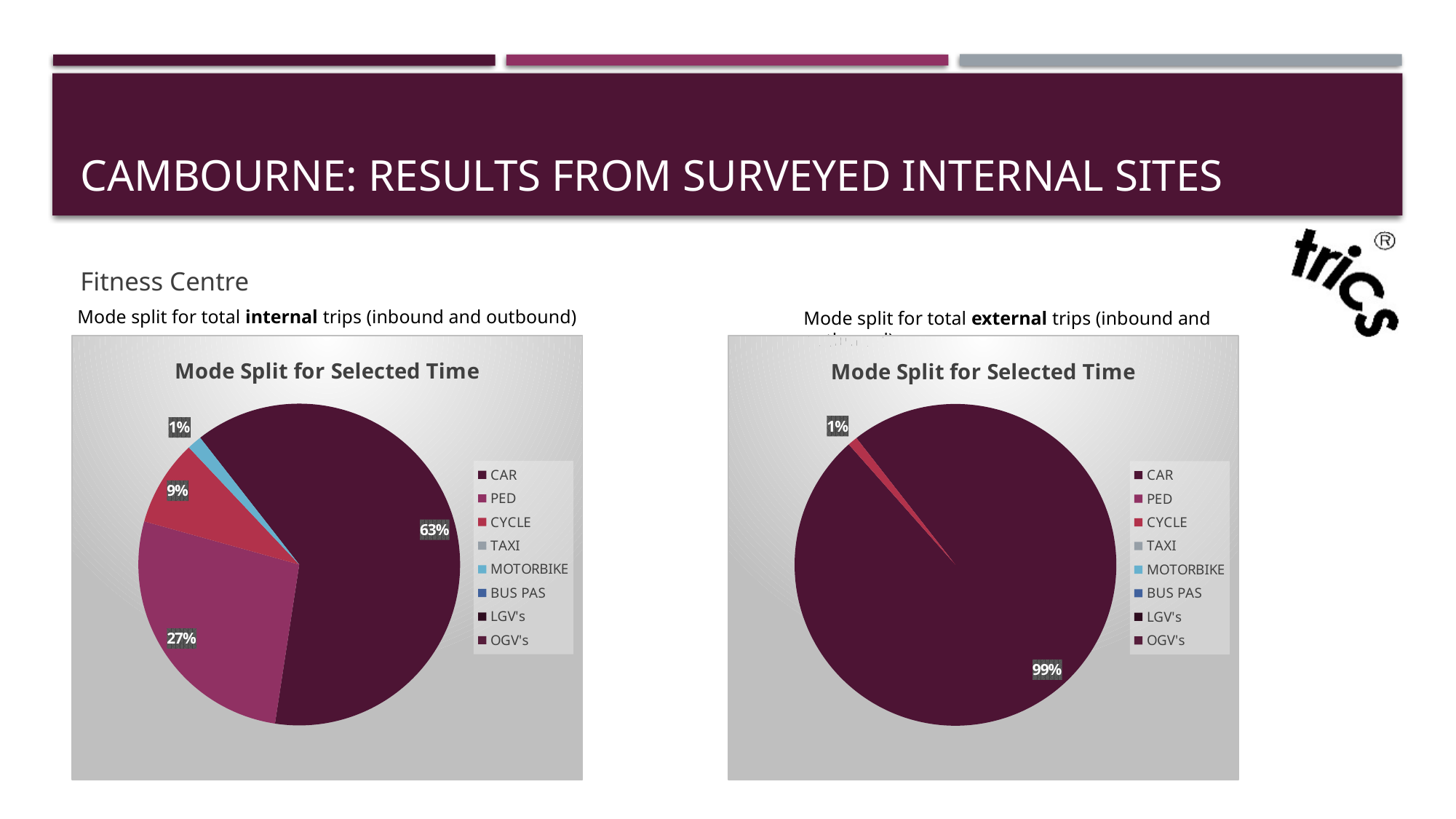
In the left pie chart (internal trips), which mode has the largest share? CAR In the left pie chart (internal trips), what share of trips is by MOTORBIKE? 1% In the left pie chart (internal trips), what is the difference between the CAR share and the PED share? 36% In the left pie chart (internal trips), which is larger, the PED share or the CYCLE share? PED What type of chart is used on the left of the slide? Pie chart In the left pie chart (internal trips), what share of trips is by CYCLE? 9% How many entries does the legend of the right pie chart (external trips) list? 8 In the left pie chart (internal trips), what share of trips is by PED? 27% In the right pie chart (external trips), what share of trips is by CYCLE? 1% In the left pie chart (internal trips), what share of trips is by CAR? 63% What is the title shown inside the left pie chart? Mode Split for Selected Time In the right pie chart (external trips), what share of trips is by CAR? 99%